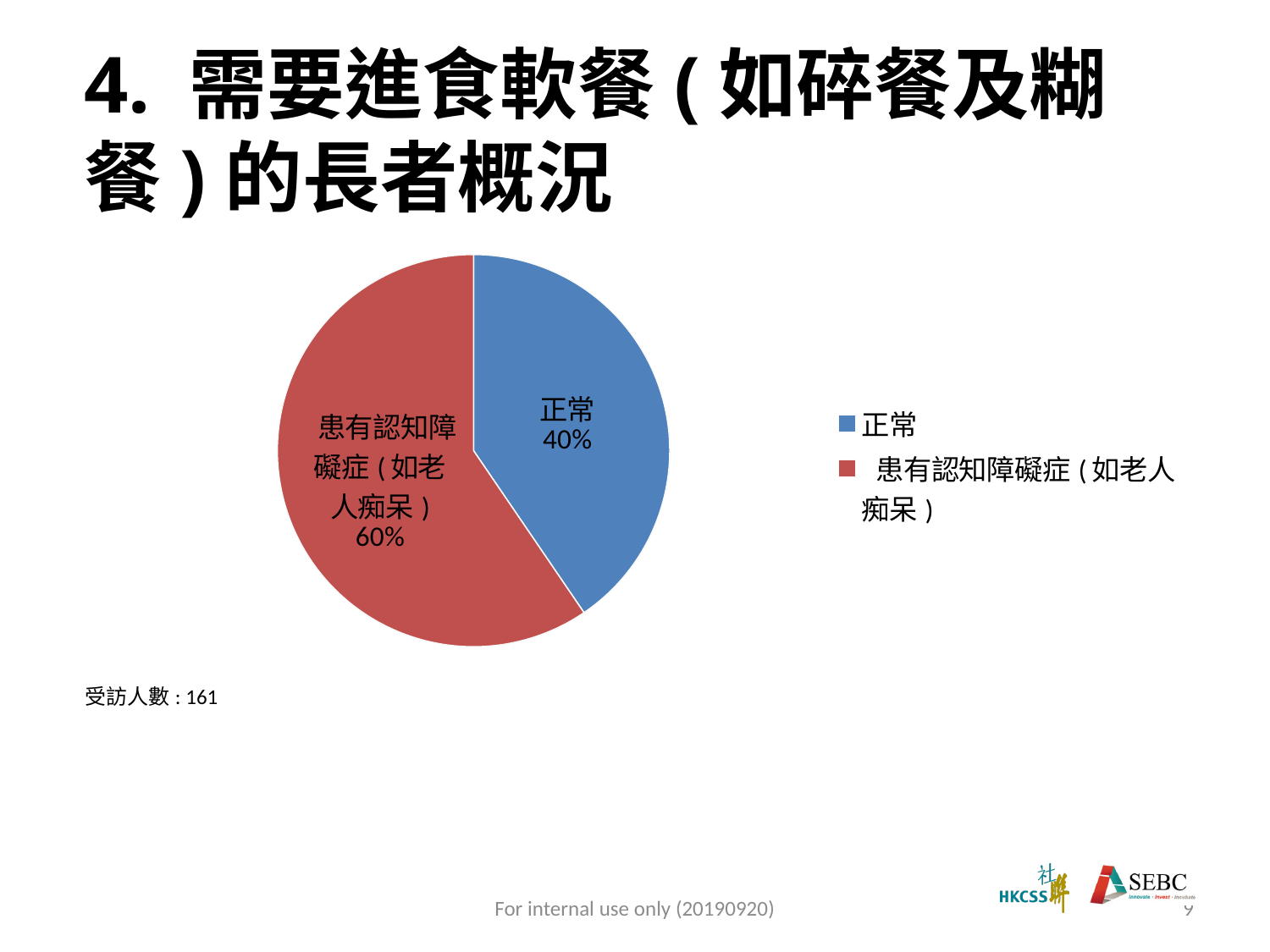
How many entries does the legend list? 2 What kind of chart is shown on the slide? pie chart What share of the pie does 患有認知障礙症（如老人痴呆）represent? 60% How many slices does the pie chart have? 2 Which is larger: the share for 正常 or the share for 患有認知障礙症（如老人痴呆）? 患有認知障礙症（如老人痴呆） Which category has the largest slice of the pie? 患有認知障礙症（如老人痴呆） What share of the pie does 正常 represent? 40% What is the difference in percentage points between 患有認知障礙症（如老人痴呆）and 正常? 20% Which category has the smallest slice of the pie? 正常 What colour is the slice for 正常? blue What colour is the slice for 患有認知障礙症（如老人痴呆）? red How many respondents (受訪人數) are stated below the chart? 161